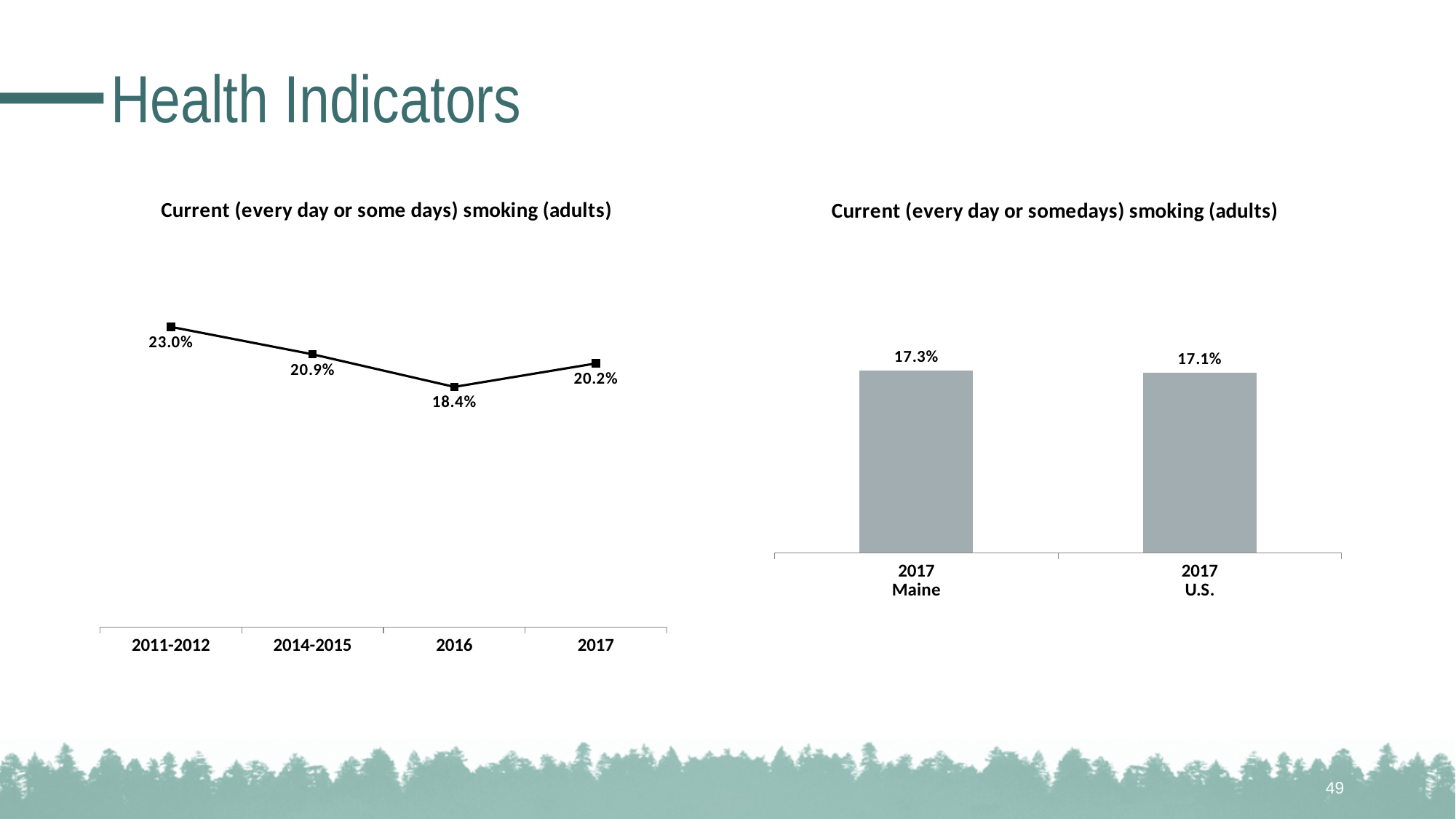
In the left chart (Current smoking, adults, over time), what is the value for 2016? 18.4% In the left chart (Current smoking, adults, over time), what is the value for 2011-2012? 23.0% In the left chart (Current smoking, adults, over time), what is the difference between the 2011-2012 value and the 2017 value? 2.8% In the left chart (Current smoking, adults, over time), how many data points are plotted? 4 In the right chart (2017 Maine vs. U.S.), what is the value for 2017 U.S.? 17.1% In the right chart (2017 Maine vs. U.S.), what is the value for 2017 Maine? 17.3% What kind of chart is the left chart (Current smoking, adults, over time)? Line chart In the left chart (Current smoking, adults, over time), does the value rise or fall from 2011-2012 to 2016? Fall In the left chart (Current smoking, adults, over time), which period has the lowest value? 2016 In the right chart (2017 Maine vs. U.S.), what is the difference between the Maine and U.S. values? 0.2% In the left chart (Current smoking, adults, over time), which period has the highest value? 2011-2012 What kind of chart is the right chart (2017 Maine vs. U.S.)? Bar chart